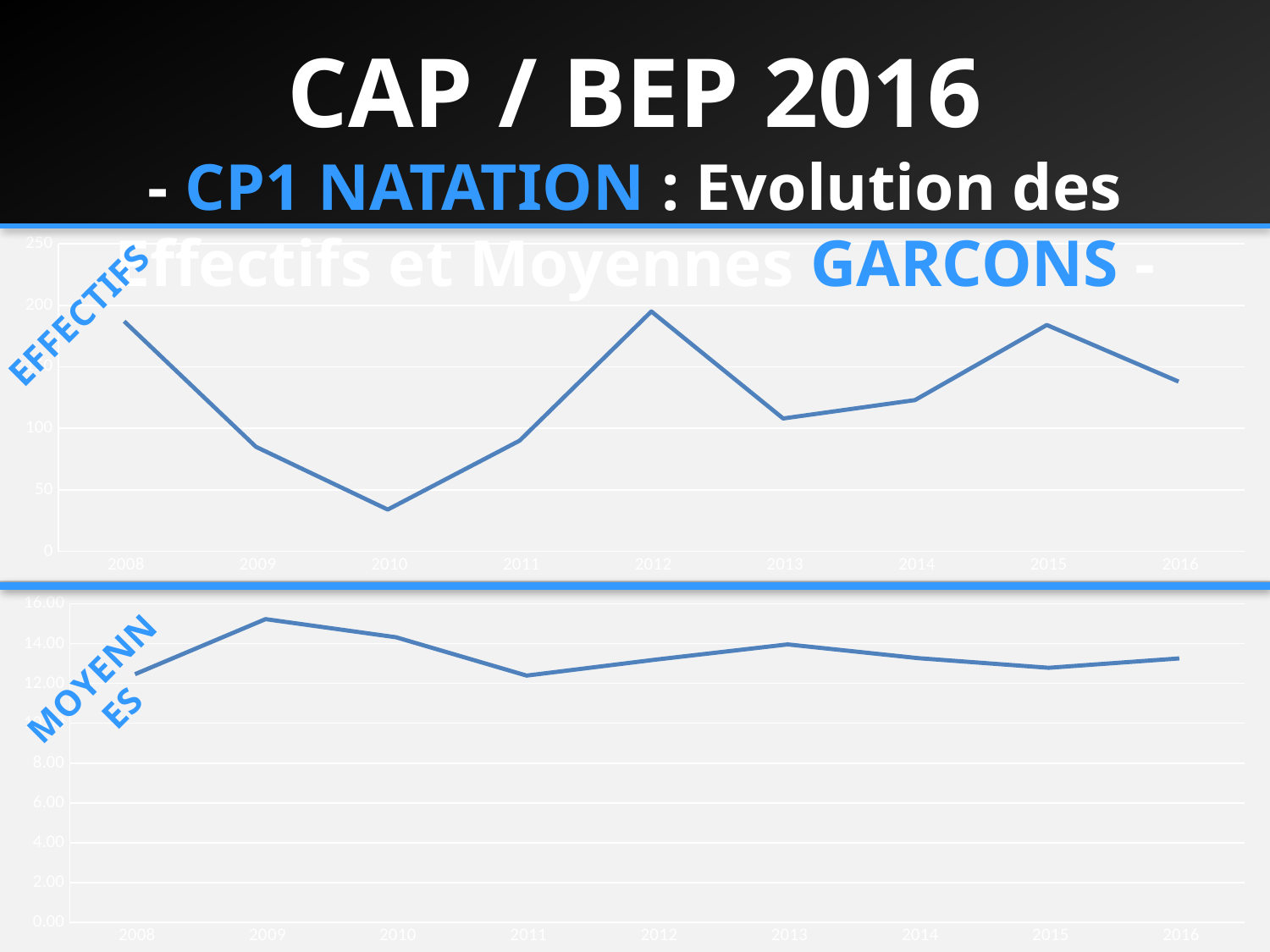
In the bottom chart (MOYENNES), which year has the highest value? 2009 In the top chart (EFFECTIFS), is the value for 2010 greater or less than 50? less In the bottom chart (MOYENNES), is the value for 2009 greater or less than 14.00? greater How many years are plotted on the x axis of the bottom chart (MOYENNES)? 9 In the top chart (EFFECTIFS), is the value for 2013 greater or less than 100? greater What kind of chart is the top chart (EFFECTIFS)? line chart In the top chart (EFFECTIFS), which is larger, the value for 2012 or the value for 2013? 2012 In the top chart (EFFECTIFS), do the values rise or fall from 2008 to 2010? fall In the top chart (EFFECTIFS), which year has the lowest value? 2010 What is the first year shown on the x axis of the top chart (EFFECTIFS)? 2008